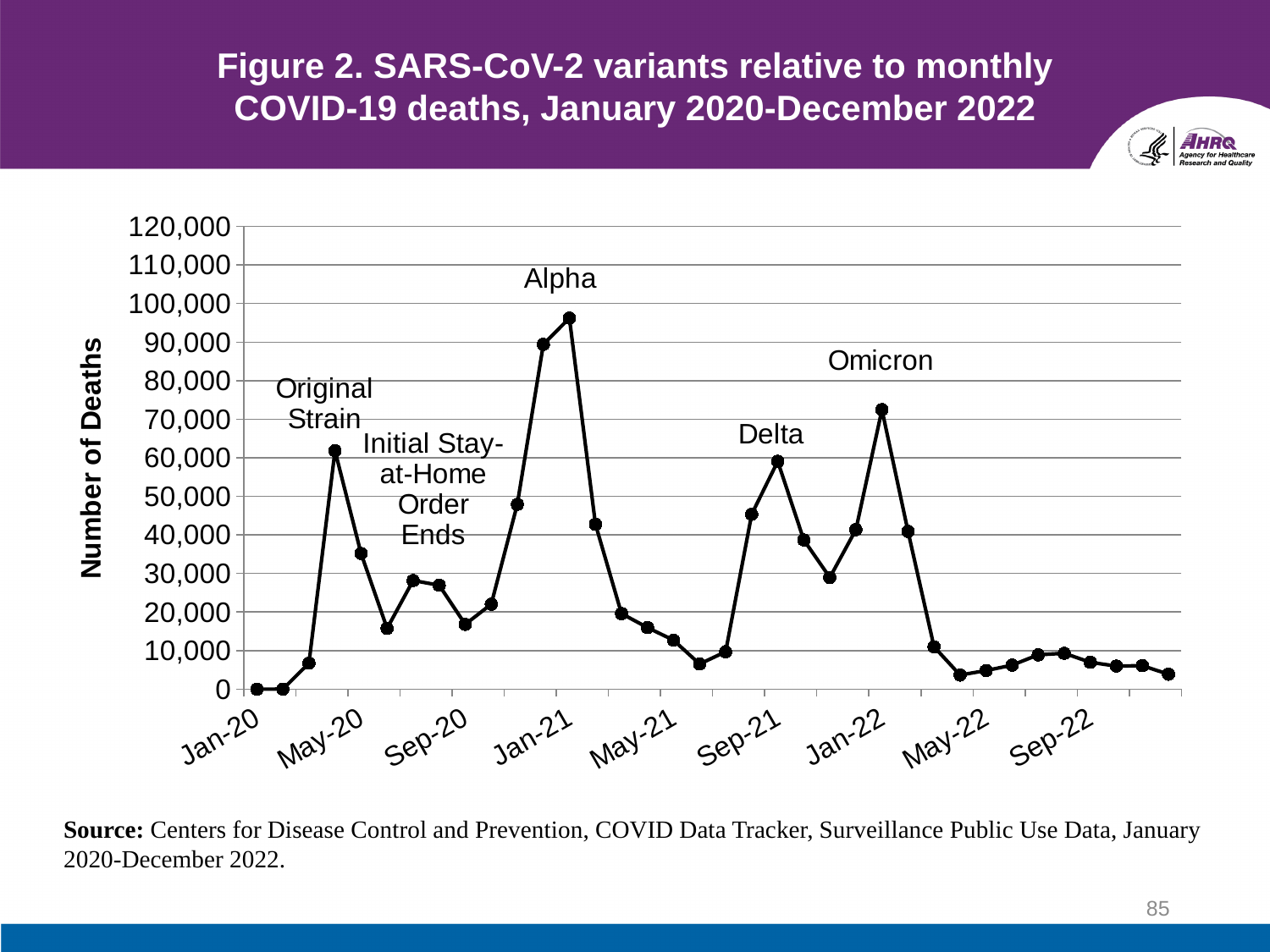
Is the value for Jan-21 greater or less than 90,000? greater Which labeled variant wave has the highest peak in monthly COVID-19 deaths? Alpha Which is larger, the number of deaths in Jan-21 or in Jan-22? Jan-21 Is the value for Sep-21 greater or less than 50,000? greater Which is larger, the peak of the Delta wave or the peak of the Omicron wave? Omicron What event is annotated on the chart between the Original Strain and Alpha peaks? Initial Stay-at-Home Order Ends What kind of chart is shown on the slide? line chart Do monthly deaths rise or fall between Jan-22 and May-22? fall Is the value for Jan-22 greater or less than 60,000? greater What is the label on the y axis? Number of Deaths